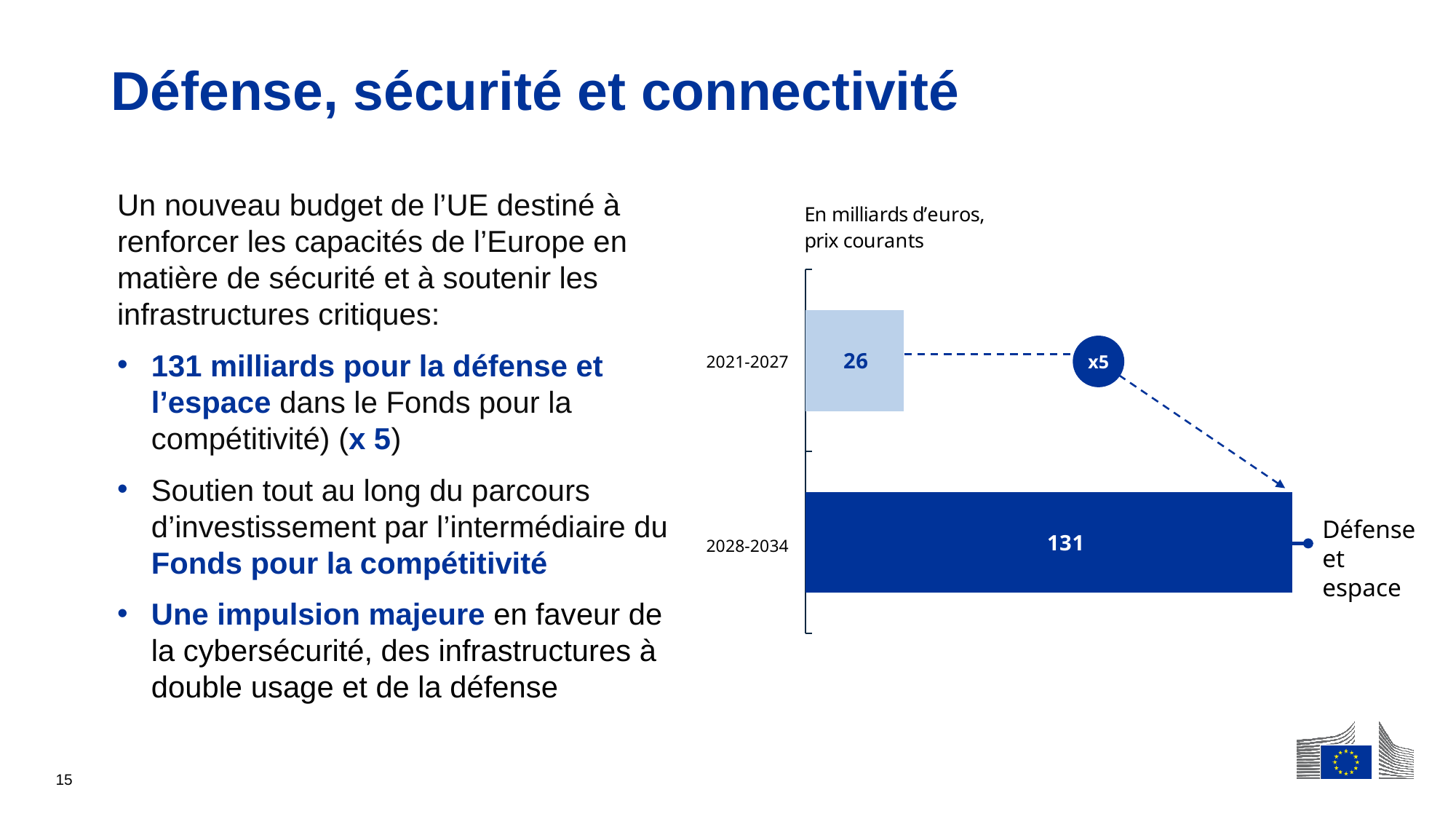
Which period has the lower value? 2021-2027 Which period has the higher value? 2028-2034 Is the value for 2028-2034 larger or smaller than the value for 2021-2027? larger What is the value for 2021-2027? 26 What is the difference between the 2028-2034 value and the 2021-2027 value? 105 What unit is stated above the chart? En milliards d'euros, prix courants What multiplier is shown in the circle between the two bars? x5 Do the values rise or fall from 2021-2027 to 2028-2034? rise How many periods are shown in the chart? 2 What kind of chart is shown on the slide? bar chart What is the value for 2028-2034? 131